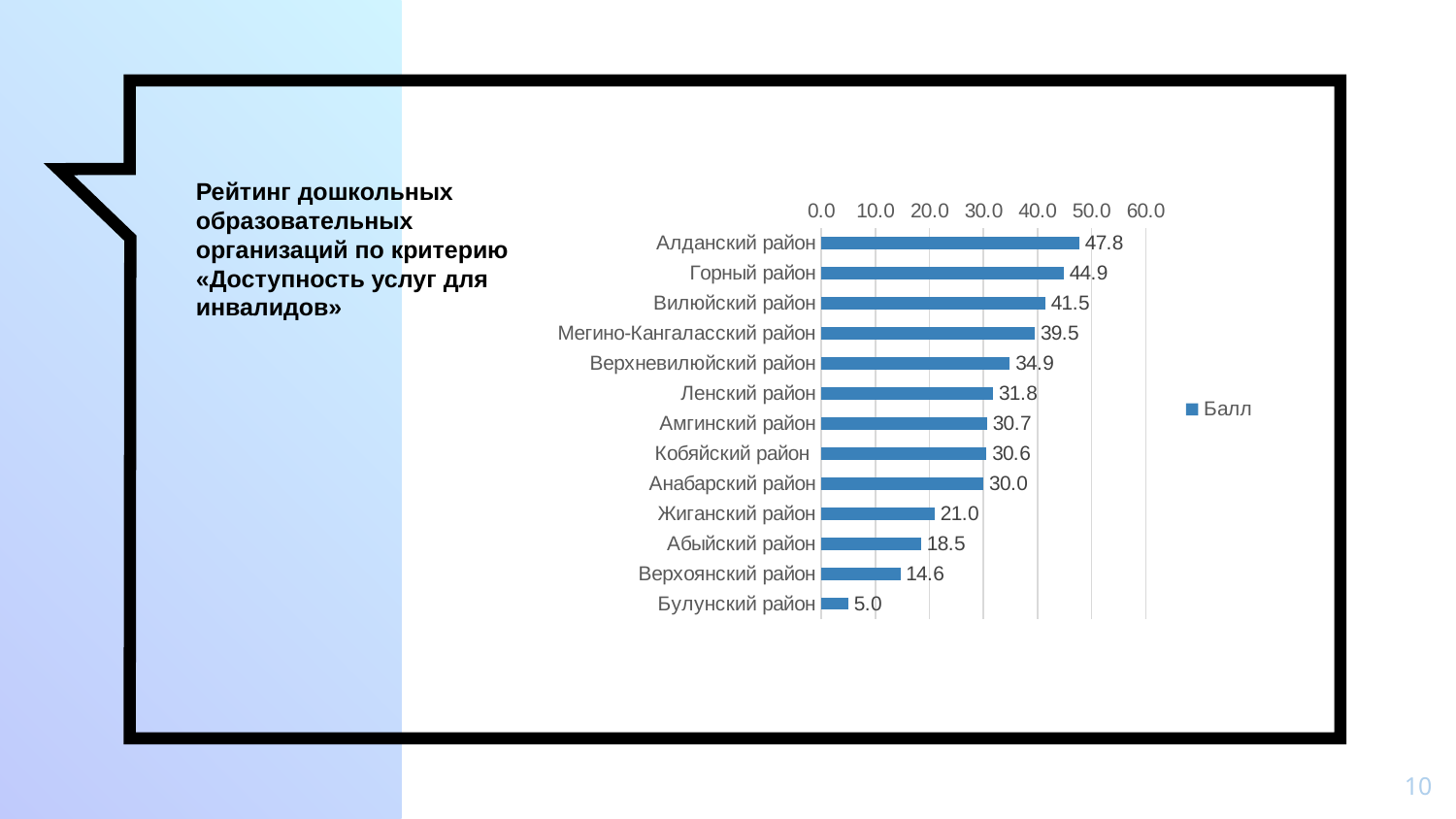
What is the value for Булунский район? 5.0 Which district has the lowest value? Булунский район What is the value for Верхоянский район? 14.6 How many series does the legend list? 1 What is the value for Алданский район? 47.8 Which is larger, the value for Ленский район or the value for Жиганский район? Ленский район What kind of chart is shown on the slide? bar chart What is the value for Мегино-Кангаласский район? 39.5 What is the name of the series in the legend? Балл How many districts are shown in the chart? 13 Which district has the highest value? Алданский район What is the difference between the values for Горный район and Вилюйский район? 3.4